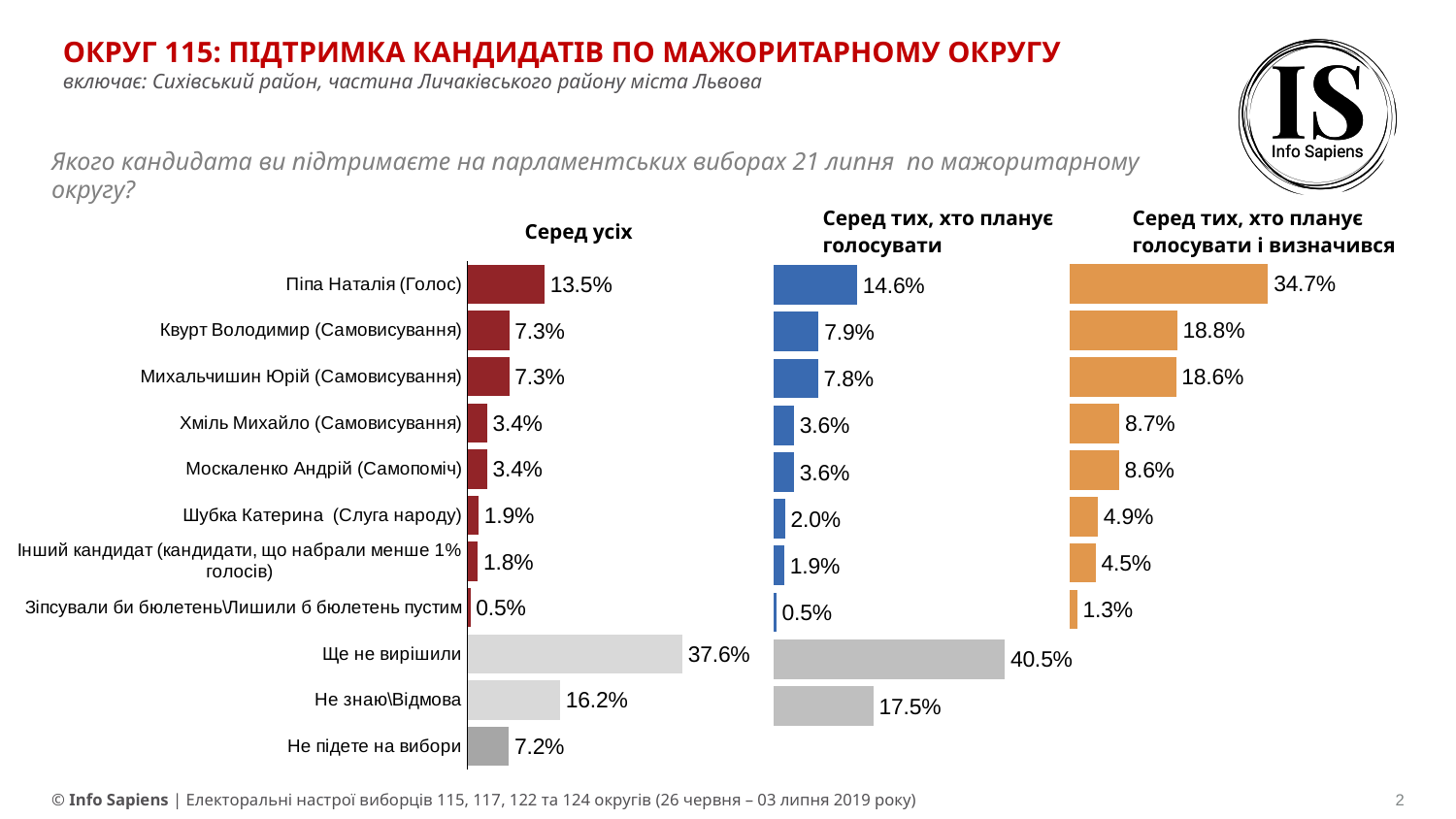
In the "Серед усіх" chart, what is the difference between Ще не вирішили and Не знаю\Відмова? 21.4% In the "Серед тих, хто планує голосувати" chart, what is the value for Ще не вирішили? 40.5% In the "Серед тих, хто планує голосувати і визначився" chart, what is the value for Квурт Володимир (Самовисування)? 18.8% What type of chart is the "Серед усіх" chart? Bar chart In the "Серед усіх" chart, what is the value for Піпа Наталія (Голос)? 13.5% What colour are the bars for candidates in the "Серед тих, хто планує голосувати і визначився" chart? Orange In the "Серед тих, хто планує голосувати і визначився" chart, what is the difference between Піпа Наталія (Голос) and Михальчишин Юрій (Самовисування)? 16.1% In the "Серед усіх" chart, which category has the highest value? Ще не вирішили How many categories does the "Серед усіх" chart show? 11 In the "Серед тих, хто планує голосувати і визначився" chart, which category has the lowest value? Зіпсували би бюлетень\Лишили б бюлетень пустим How many categories does the "Серед тих, хто планує голосувати і визначився" chart show? 8 In the "Серед тих, хто планує голосувати" chart, which is larger: Піпа Наталія (Голос) or Квурт Володимир (Самовисування)? Піпа Наталія (Голос)